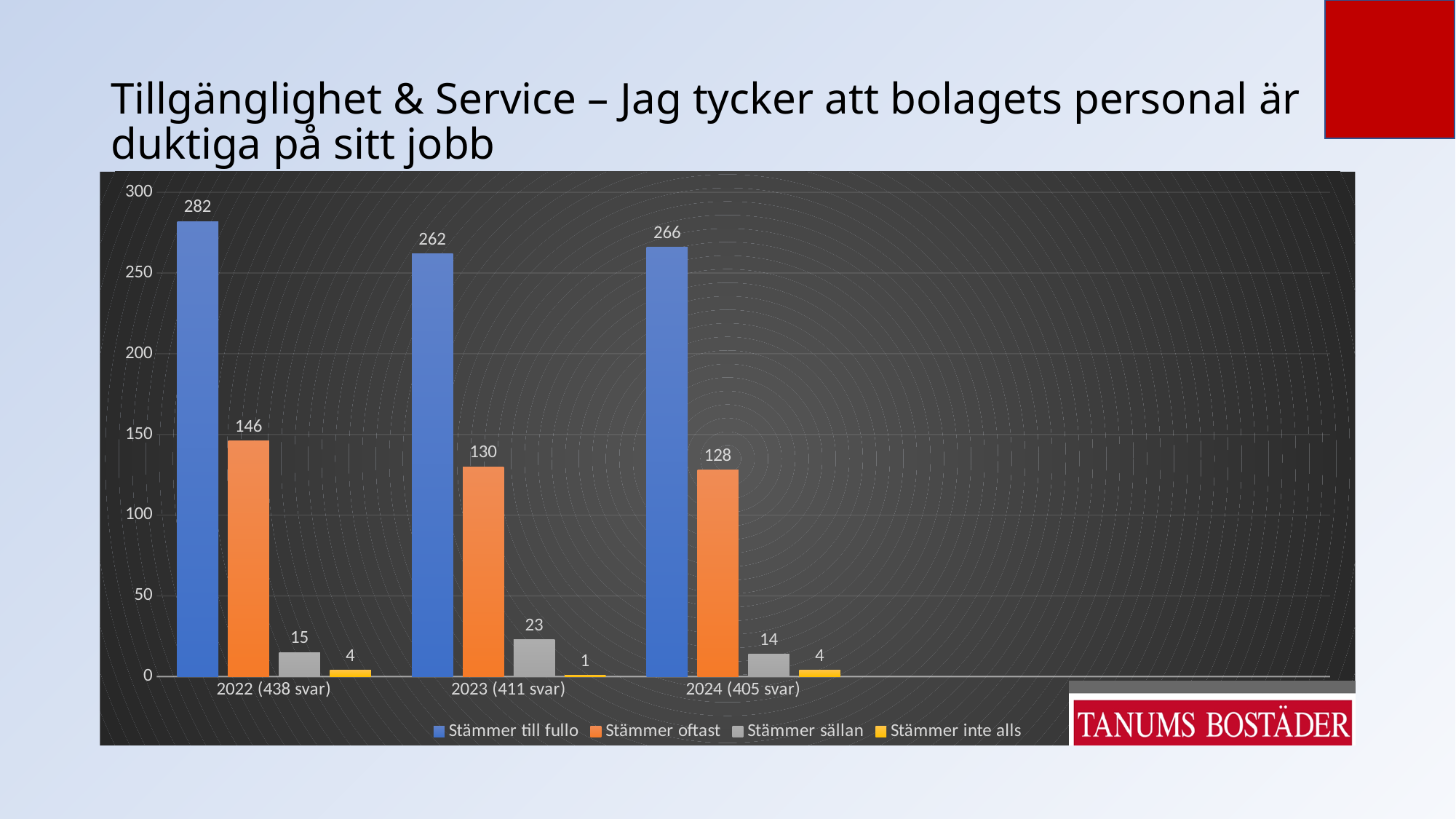
What is the value for 'Stämmer oftast' in 2024 (405 svar)? 128 Which is larger: 'Stämmer till fullo' in 2023 (411 svar) or in 2024 (405 svar)? 2024 (405 svar) What is the value for 'Stämmer sällan' in 2023 (411 svar)? 23 In which year is the value for 'Stämmer till fullo' highest? 2022 (438 svar) Which colour represents 'Stämmer inte alls' in the legend? Yellow What is the difference between the 'Stämmer oftast' values for 2022 (438 svar) and 2023 (411 svar)? 16 How many series does the legend list? 4 What is the value for 'Stämmer till fullo' in 2022 (438 svar)? 282 What is the value for 'Stämmer inte alls' in 2023 (411 svar)? 1 How many year categories are shown on the x axis? 3 What kind of chart is shown on the slide? Bar chart In which year is the value for 'Stämmer sällan' lowest? 2024 (405 svar)